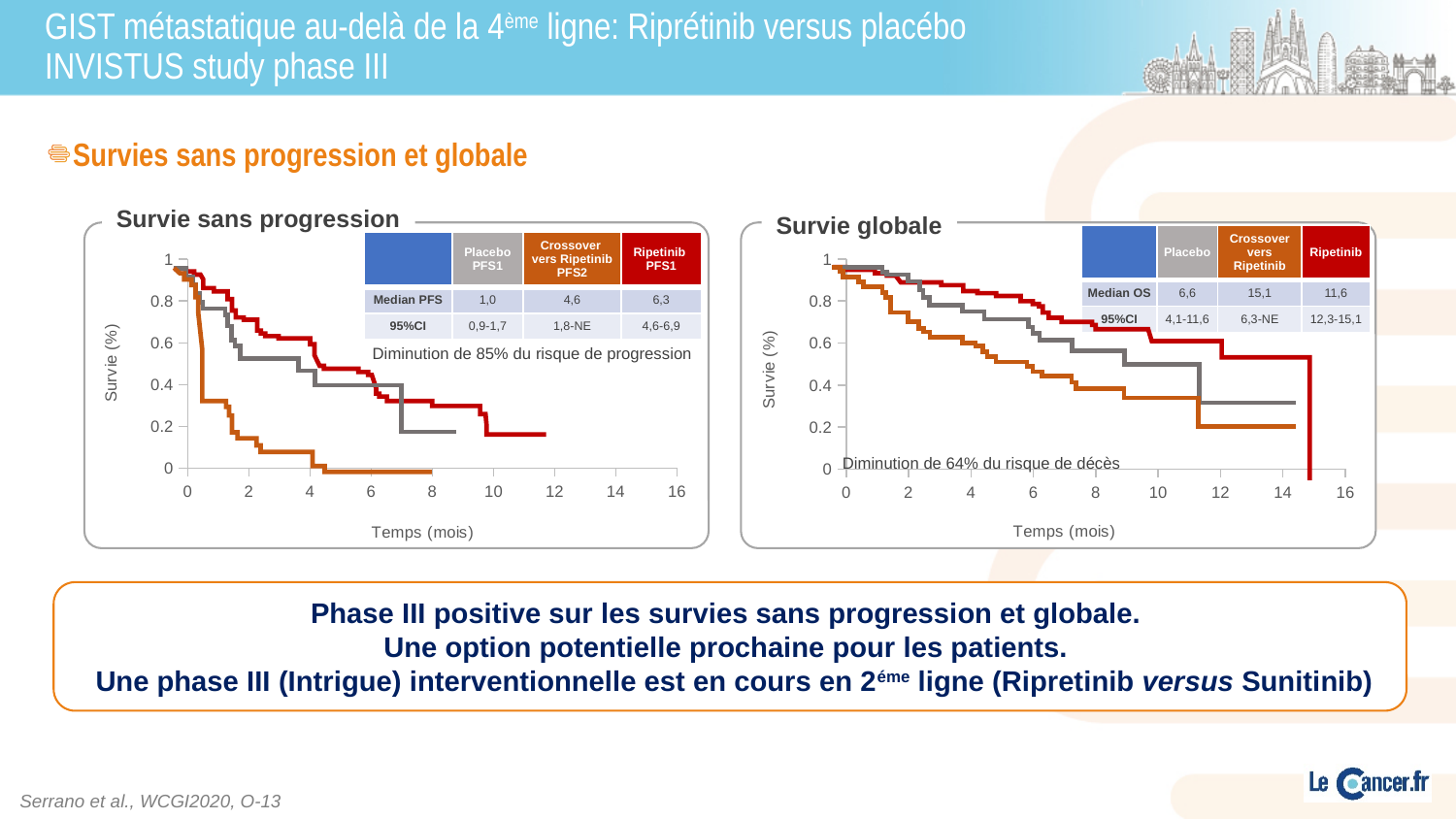
In the 'Survie sans progression' chart, which group has the highest Median PFS? Ripetinib In the 'Survie globale' chart, is the Median OS larger for Ripetinib or for Crossover vers Ripetinib? Crossover vers Ripetinib In the 'Survie globale' chart, what is the Median OS for Crossover vers Ripetinib? 15,1 How many groups are listed in the table of the 'Survie sans progression' chart? 3 In the 'Survie sans progression' chart, what is the difference between the Median PFS of Ripetinib and Placebo? 5,3 What kind of chart is the 'Survie sans progression' chart? line chart In the 'Survie sans progression' chart, what is the Median PFS for Placebo? 1,0 In the 'Survie sans progression' chart, what is the Median PFS for Ripetinib? 6,3 What is the x-axis label of the 'Survie globale' chart? Temps (mois) In the 'Survie globale' chart, which group has the lowest Median OS? Placebo In the 'Survie globale' chart, what is the 95%CI for Ripetinib? 12,3-15,1 In the 'Survie globale' chart, what is the Median OS for Placebo? 6,6